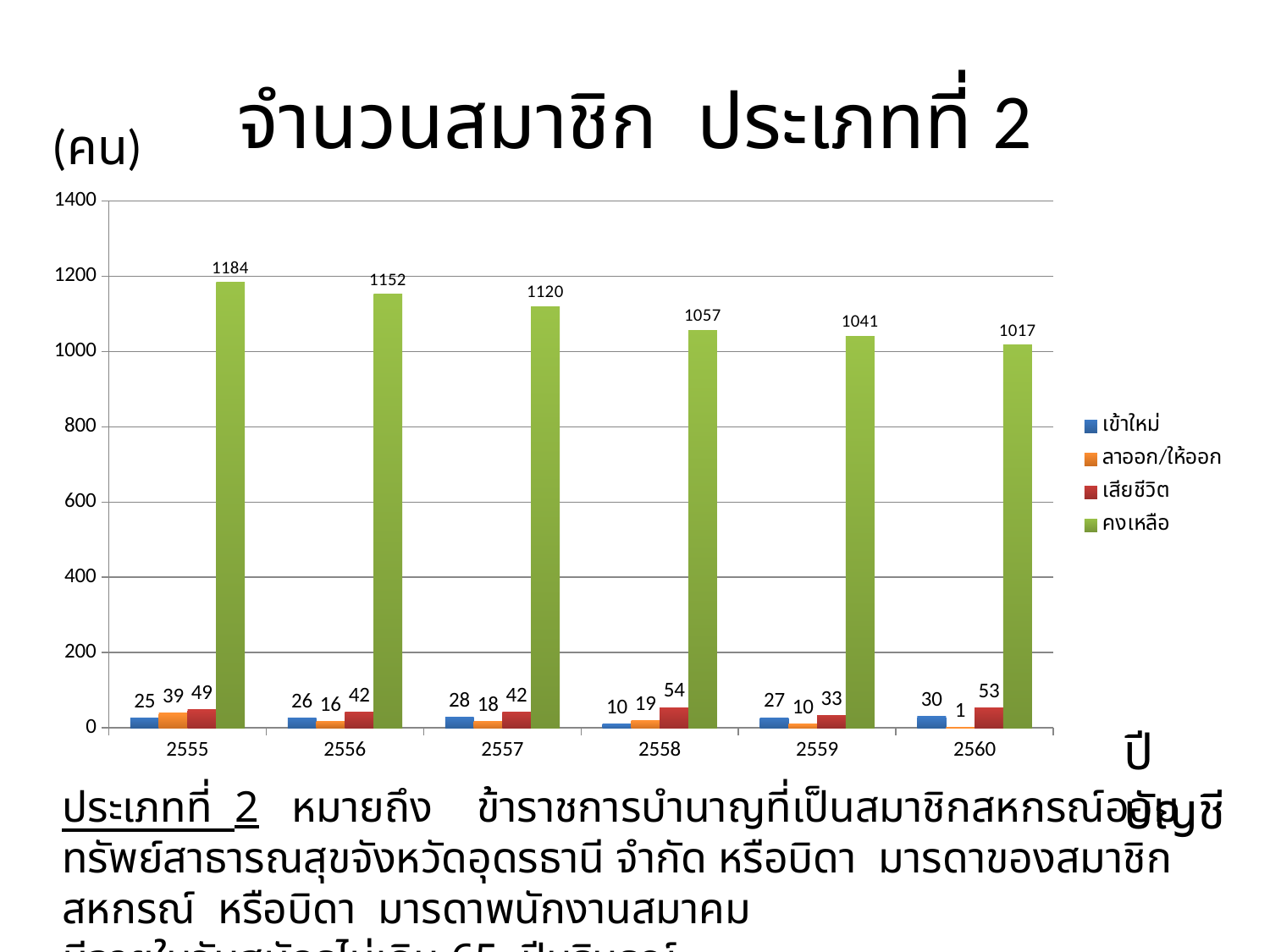
In which year is คงเหลือ the lowest? 2560 What is the value of เสียชีวิต for 2558? 54 What is the value of คงเหลือ for 2555? 1184 What is the difference between คงเหลือ in 2555 and in 2556? 32 Which is larger, ลาออก/ให้ออก in 2555 or in 2556? 2555 Does คงเหลือ rise or fall from 2555 to 2560? fall How many series does the legend list? 4 What is the value of ลาออก/ให้ออก for 2560? 1 What is the value of เข้าใหม่ for 2557? 28 How many years are shown on the x axis? 6 In which year is เข้าใหม่ the highest? 2560 What kind of chart is shown on the slide? bar chart